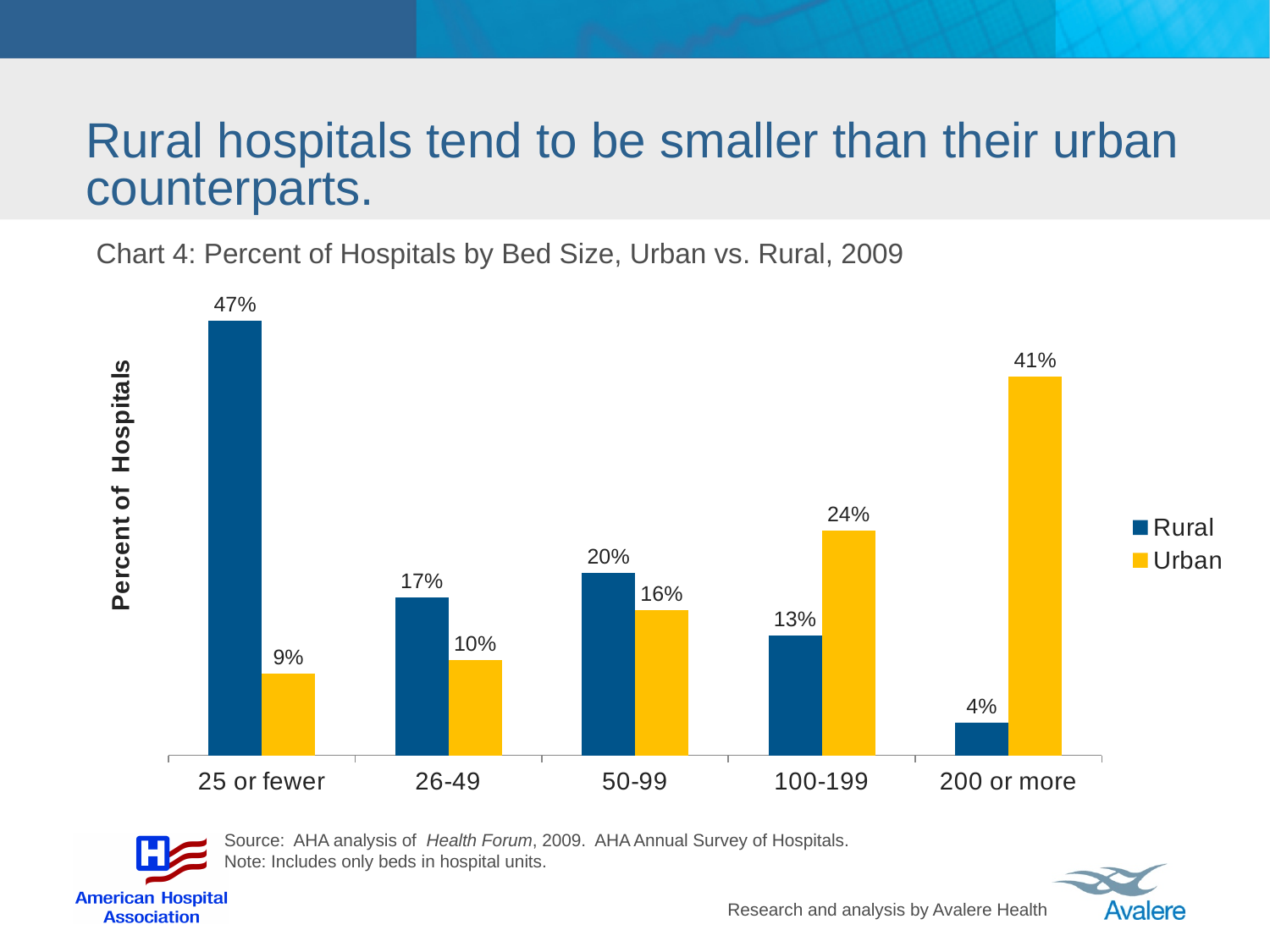
What type of chart is shown on the slide? Bar chart For the 50-99 bed size category, which is larger, the Rural or the Urban value? Rural Which bed size category has the lowest Rural value? 200 or more What is the difference between the Rural and Urban values for the 25 or fewer category? 38% How many series does the legend list? 2 What is the Urban value for the 100-199 bed size category? 24% What is the difference between the Urban and Rural values for the 200 or more category? 37% What percent of rural hospitals have 25 or fewer beds? 47% What percent of urban hospitals have 200 or more beds? 41% Which bed size category has the highest Rural value? 25 or fewer Which bed size category has the lowest Urban value? 25 or fewer How many bed size categories are shown on the x axis? 5